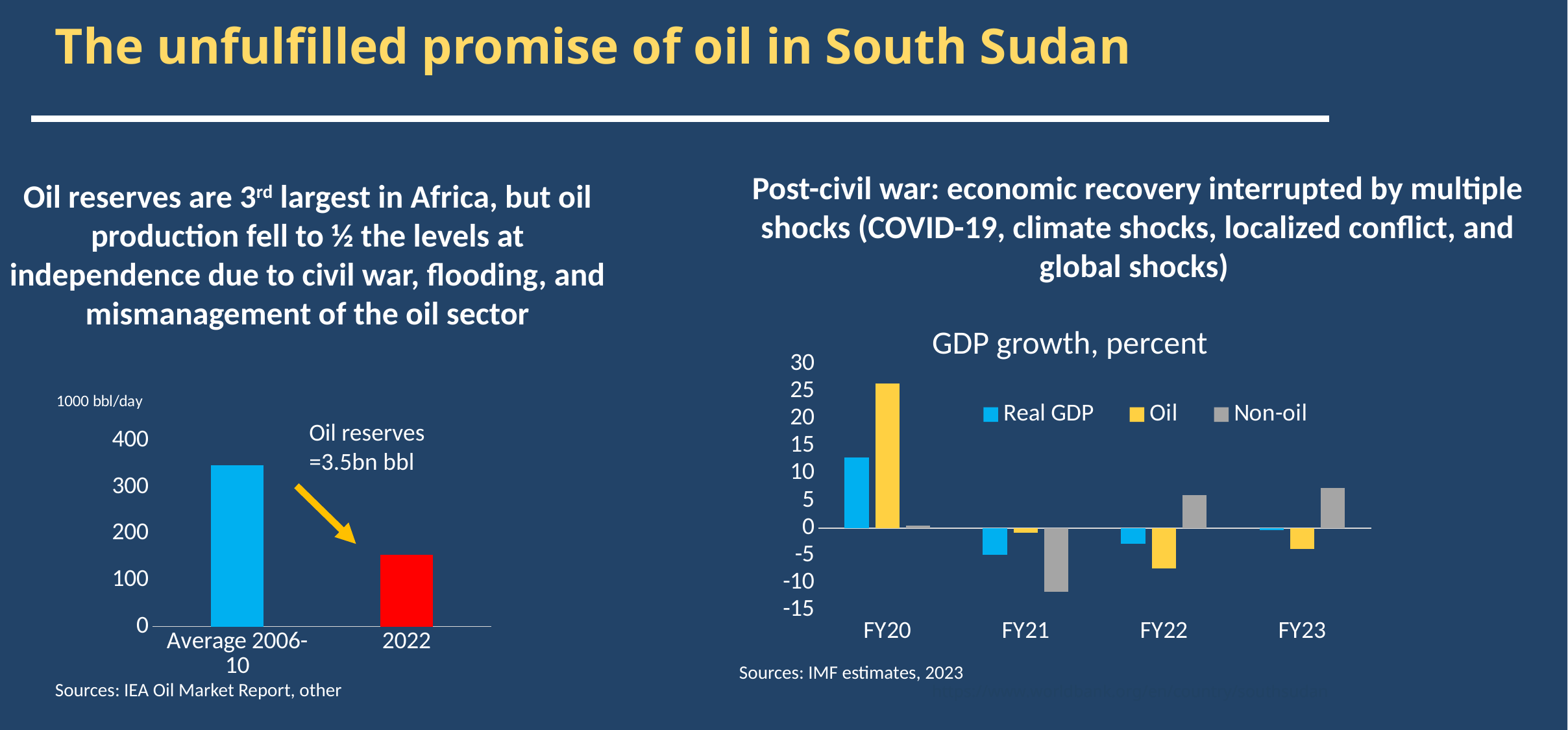
On the left chart (1000 bbl/day), do the values rise or fall from Average 2006-10 to 2022? fall On the left chart (1000 bbl/day), is the value for Average 2006-10 greater or less than 300? greater On the 'GDP growth, percent' chart, is the Oil value for FY20 greater or less than 20? greater On the 'GDP growth, percent' chart, how many fiscal years are shown on the x axis? 4 On the left chart (1000 bbl/day), which category has the higher value? Average 2006-10 On the 'GDP growth, percent' chart, which is larger in FY22: Non-oil or Oil? Non-oil On the left chart (1000 bbl/day), what kind of chart is shown? bar chart On the left chart (1000 bbl/day), is the value for 2022 greater or less than 200? less On the 'GDP growth, percent' chart, which series has the highest value in FY20? Oil On the 'GDP growth, percent' chart, which series has the lowest value in FY21? Non-oil On the 'GDP growth, percent' chart, how many series does the legend list? 3 On the left chart (1000 bbl/day), how many categories are plotted? 2